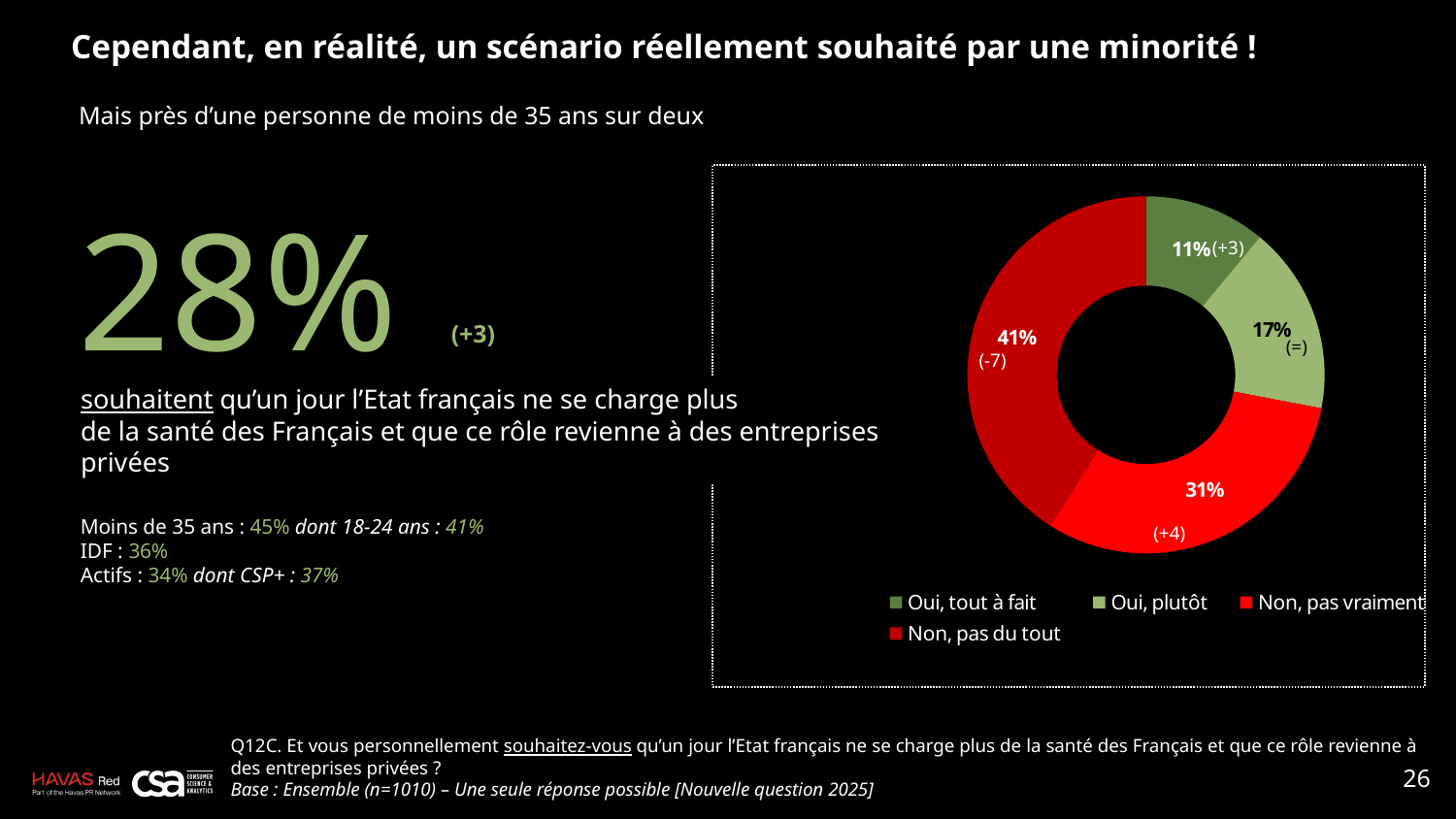
What type of chart is shown on the slide? Donut (pie) chart Which category has the smallest share in the donut chart? Oui, tout à fait What is the combined share of the two "Oui" categories in the donut chart? 28% What is the value for "Oui, tout à fait" in the donut chart? 11% Which is larger in the donut chart: "Oui, plutôt" or "Oui, tout à fait"? Oui, plutôt What is the value for "Oui, plutôt" in the donut chart? 17% What is the value for "Non, pas vraiment" in the donut chart? 31% What is the difference between the shares of "Non, pas du tout" and "Non, pas vraiment"? 10 percentage points Which category has the largest share in the donut chart? Non, pas du tout What change is indicated next to the "Non, pas du tout" slice in the donut chart? (-7) What is the value for "Non, pas du tout" in the donut chart? 41% How many categories does the donut chart show? 4